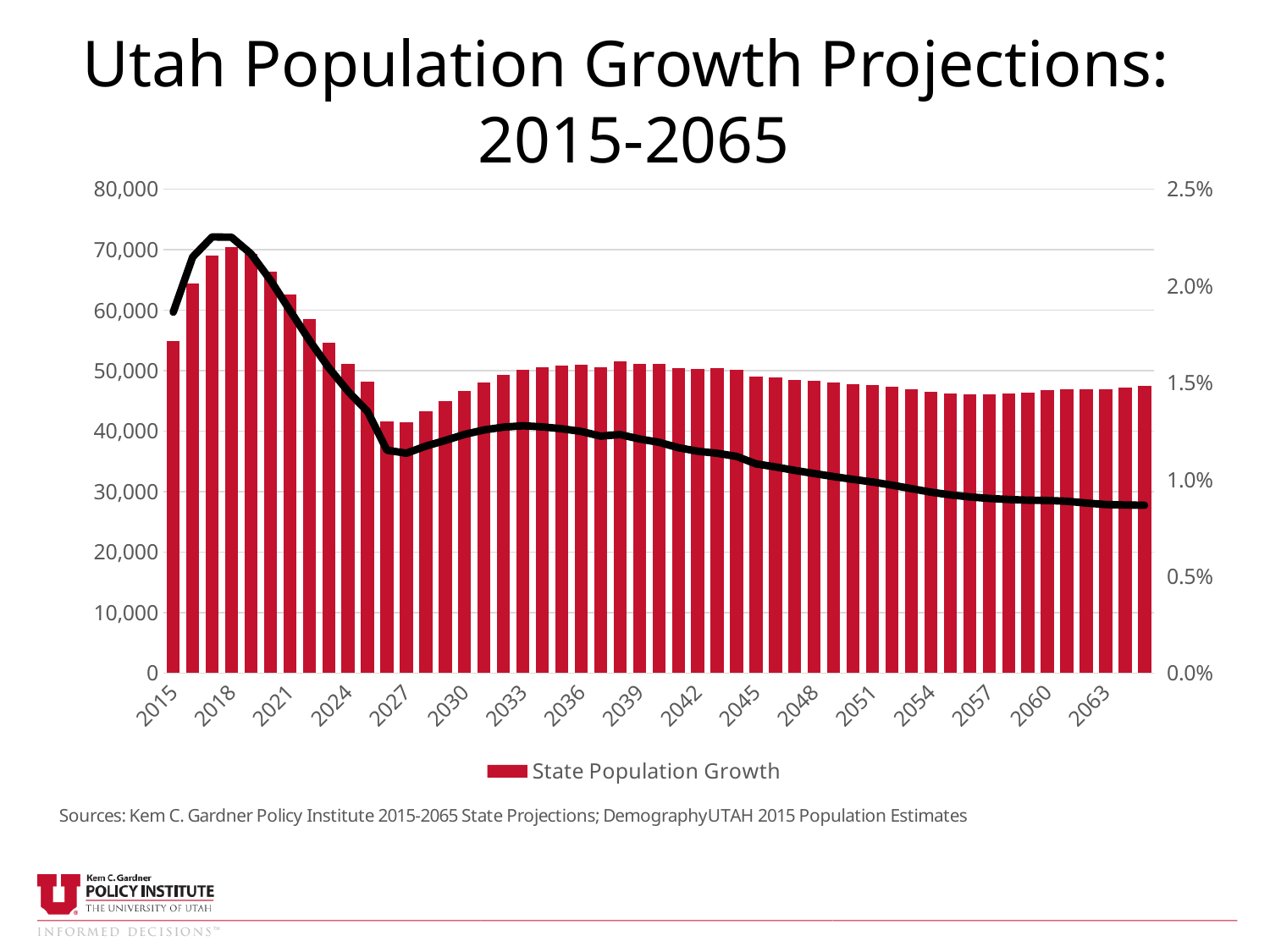
How many series does the legend list? 1 Is the bar value for 2027 greater or less than 50,000? less Is the bar value for 2018 greater or less than 60,000? greater What is the title of the chart? Utah Population Growth Projections: 2015-2065 What kind of chart is shown on the slide? A bar chart with a line overlay Is the line value for 2018 greater or less than 2.0%? greater Which year has the tallest bar? 2018 What is the legend entry for the bars? State Population Growth Which year has the larger bar, 2021 or 2030? 2021